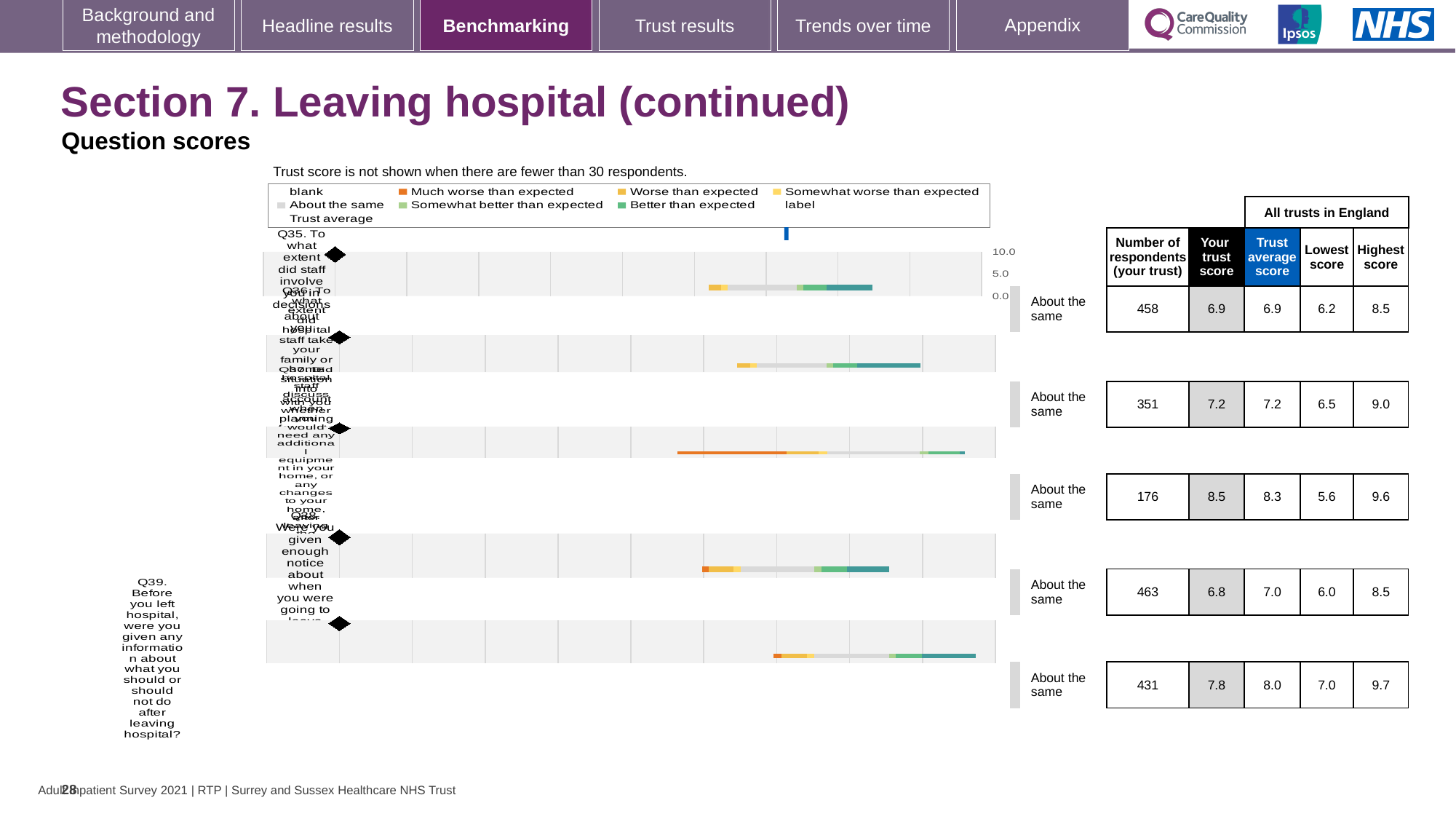
How many questions (rows) are plotted in the benchmarking chart? 5 What type of chart is used to show the question scores on this slide? bar chart What benchmark category is shown for every question on this slide? About the same What is the difference between the highest score and the lowest score for the third row (8.5 trust score)? 4.0 What is the lowest score across all trusts in England for the second row (351 respondents)? 6.5 What is the trust score for Q35 (the first row) in the table? 6.9 What is the highest score across all trusts in England for Q39 (the last row)? 9.7 For the fourth row (463 respondents), is the trust score or the trust average score larger? trust average score (7.0) What is the difference between the trust score and the trust average score for Q39 (the last row)? 0.2 How many respondents does the table show for Q39 (the last row)? 431 Which row has the lowest 'Your trust score' in the table? the fourth row (6.8) Which row has the highest 'Your trust score' in the table? the third row (8.5)